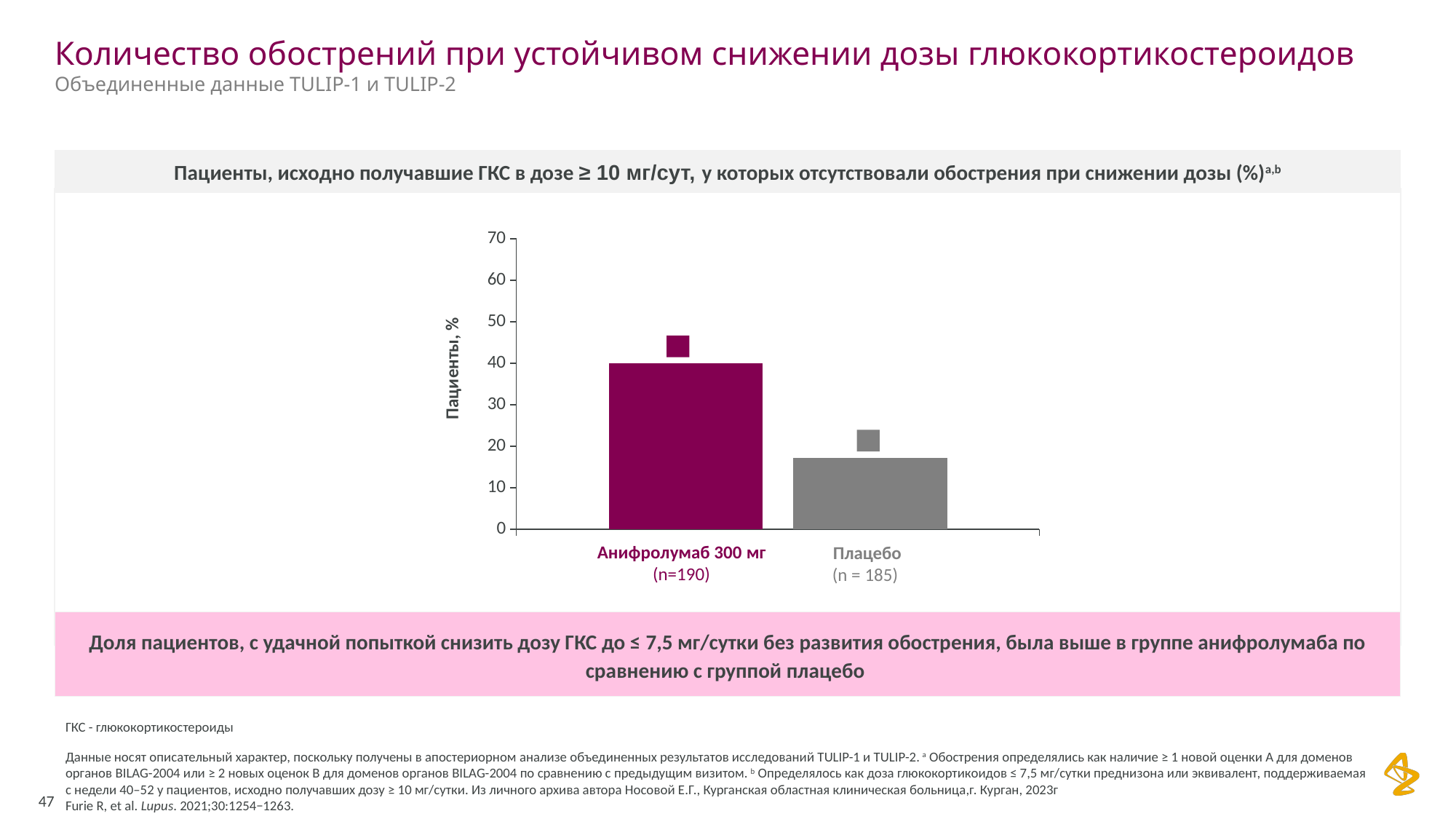
Is the value for Плацебо greater or less than 10? greater Is the value for Анифролумаб 300 мг greater or less than 50? less What is the highest value shown on the y axis of the chart? 70 How many bars (categories) are plotted in the chart? 2 Is the value for Анифролумаб 300 мг greater or less than 30? greater Which group has the lower bar in the chart? Плацебо What is the number of patients (n) shown under the Плацебо bar? n = 185 Which group has the higher bar in the chart? Анифролумаб 300 мг Which is larger: the value for Анифролумаб 300 мг or the value for Плацебо? Анифролумаб 300 мг What kind of chart is shown on the slide? bar chart What is the label of the y axis of the chart? Пациенты, %